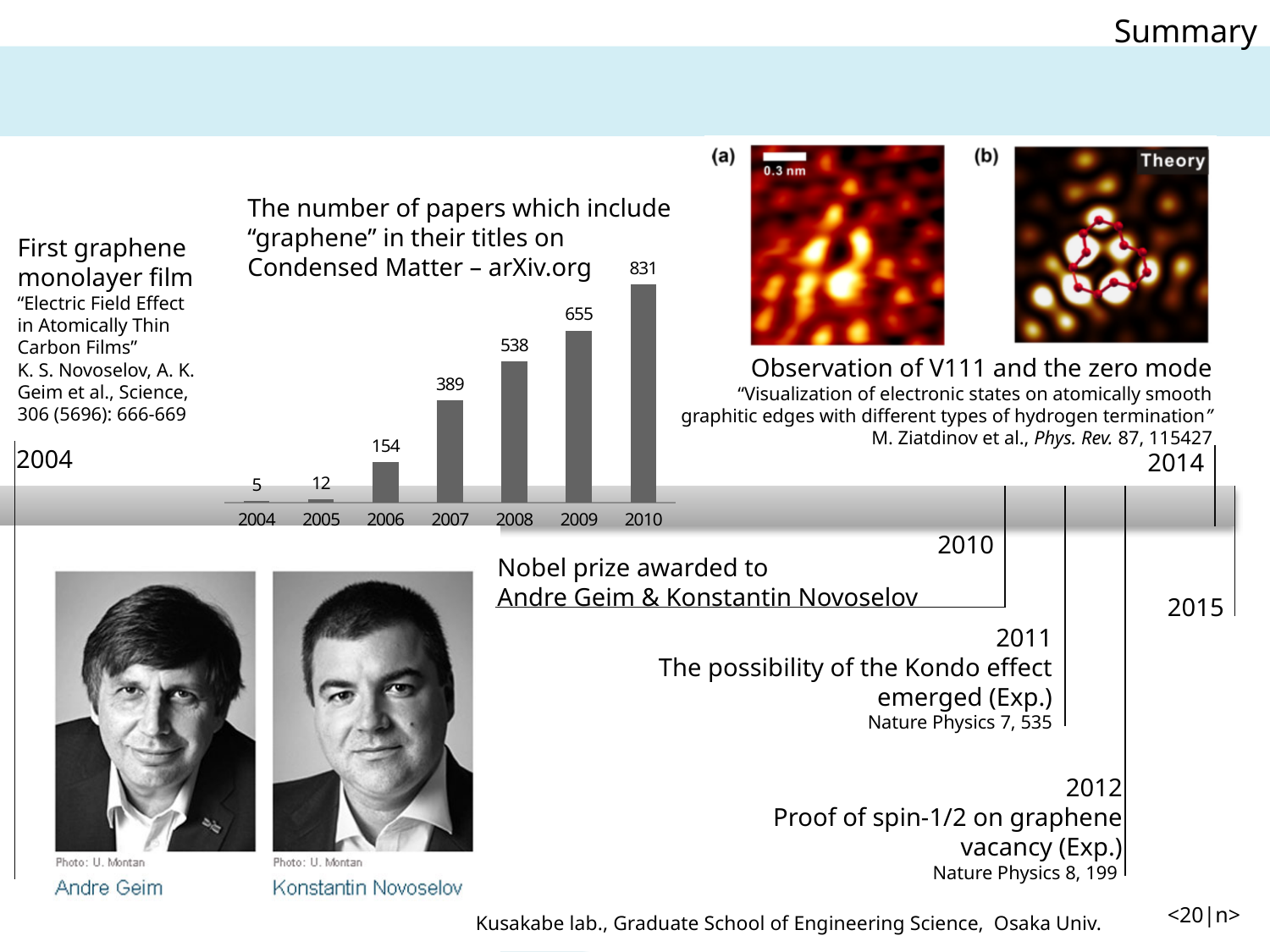
What is the difference between the number of papers in 2006 and 2005? 142 Which year has the highest number of papers in the bar chart? 2010 What is the number of papers shown for 2004 in the bar chart? 5 Do the values in the bar chart rise or fall from 2004 to 2010? rise What is the difference between the number of papers in 2010 and 2009? 176 What kind of chart is used to show the number of papers? bar chart Which year has more papers, 2008 or 2007? 2008 What is the number of papers shown for 2010 in the bar chart? 831 What is the number of papers shown for 2007 in the bar chart? 389 How many years are shown on the x axis of the bar chart? 7 According to the chart's title, what source are the paper counts taken from? Condensed Matter – arXiv.org Which year has the lowest number of papers in the bar chart? 2004